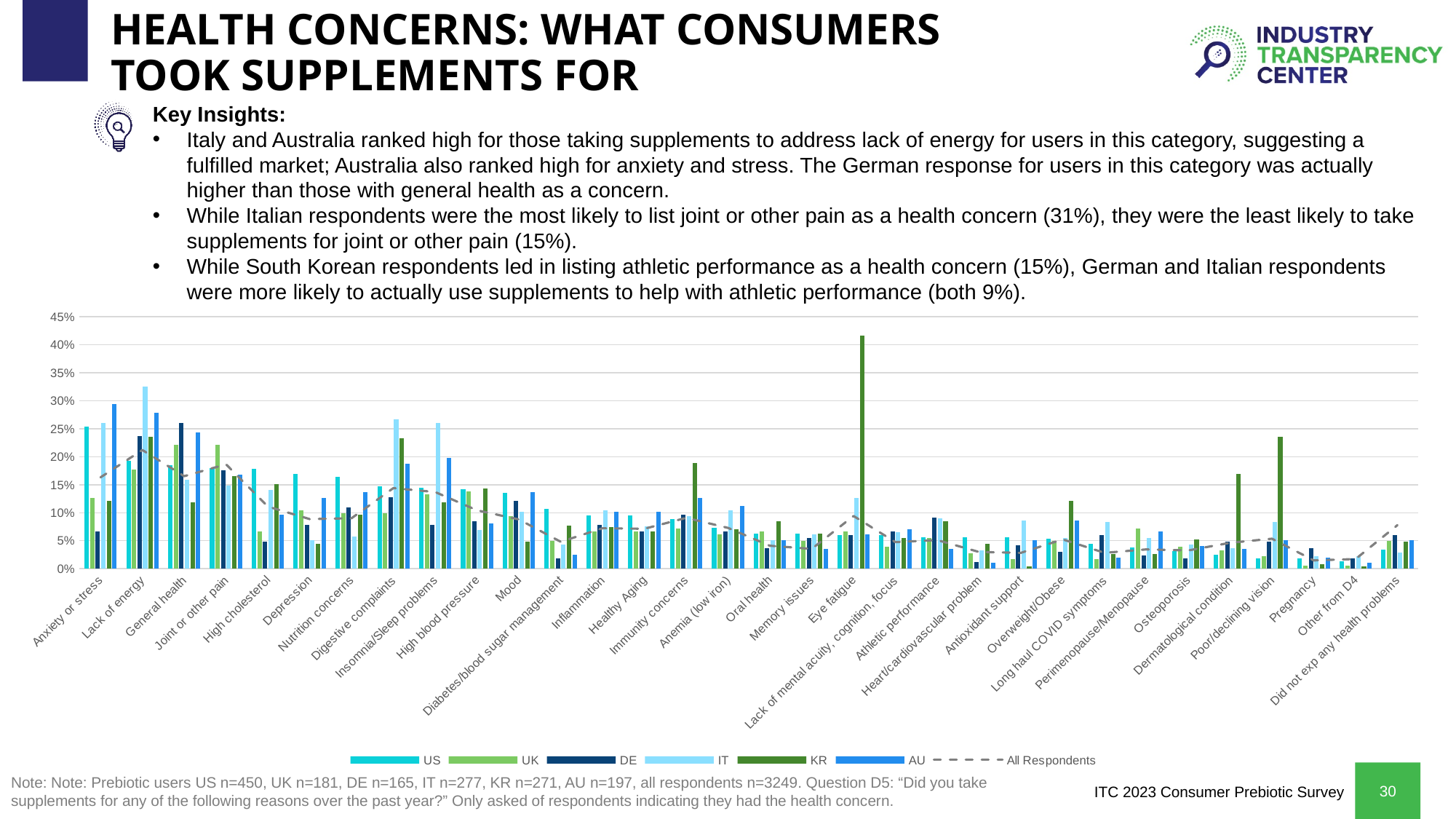
What kind of chart is shown on the slide? Bar chart (with a dashed line for All Respondents) Is the KR value for Eye fatigue greater or less than 35%? greater For Lack of energy, which is larger: the IT value or the US value? IT Which series is drawn as a dashed grey line rather than bars? All Respondents Which category contains the tallest bar in the chart? Eye fatigue How many series does the chart legend list? 7 Is the IT value for Lack of energy greater or less than 30%? greater Which series has the tallest bar for Eye fatigue? KR Which series has the tallest bar for Lack of energy? IT How many health-concern categories are shown along the x axis? 32 Is the US value for Pregnancy greater or less than 5%? less